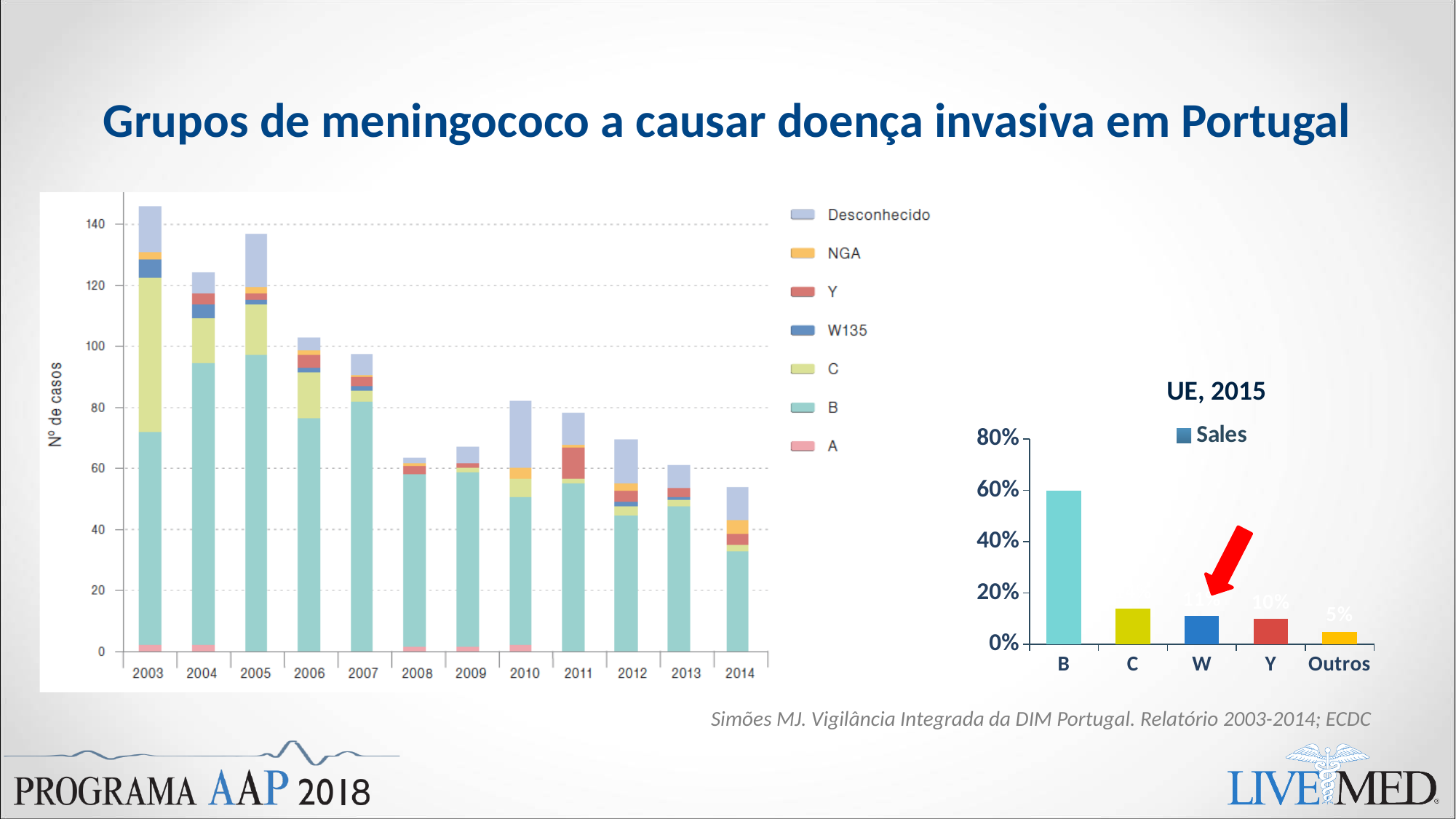
In the left chart, which year has the shortest total bar? 2014 In the 'UE, 2015' chart, is the value for B greater or less than 40%? greater How many years are shown on the x axis of the left chart? 12 How many series does the legend of the left chart list? 7 In the left chart, is the total number of cases in 2003 greater or less than 140? greater In the 'UE, 2015' chart, which group has the highest value? B In the 'UE, 2015' chart, what is the value for Outros? 5% In the left chart, which year has the tallest total bar? 2003 In the 'UE, 2015' chart, what is the value for Y? 10% What kind of chart is the left chart showing cases from 2003 to 2014? Stacked bar chart In the left chart, do the total cases generally rise or fall from 2003 to 2014? fall In the left chart, is the total number of cases in 2014 greater or less than 60? less